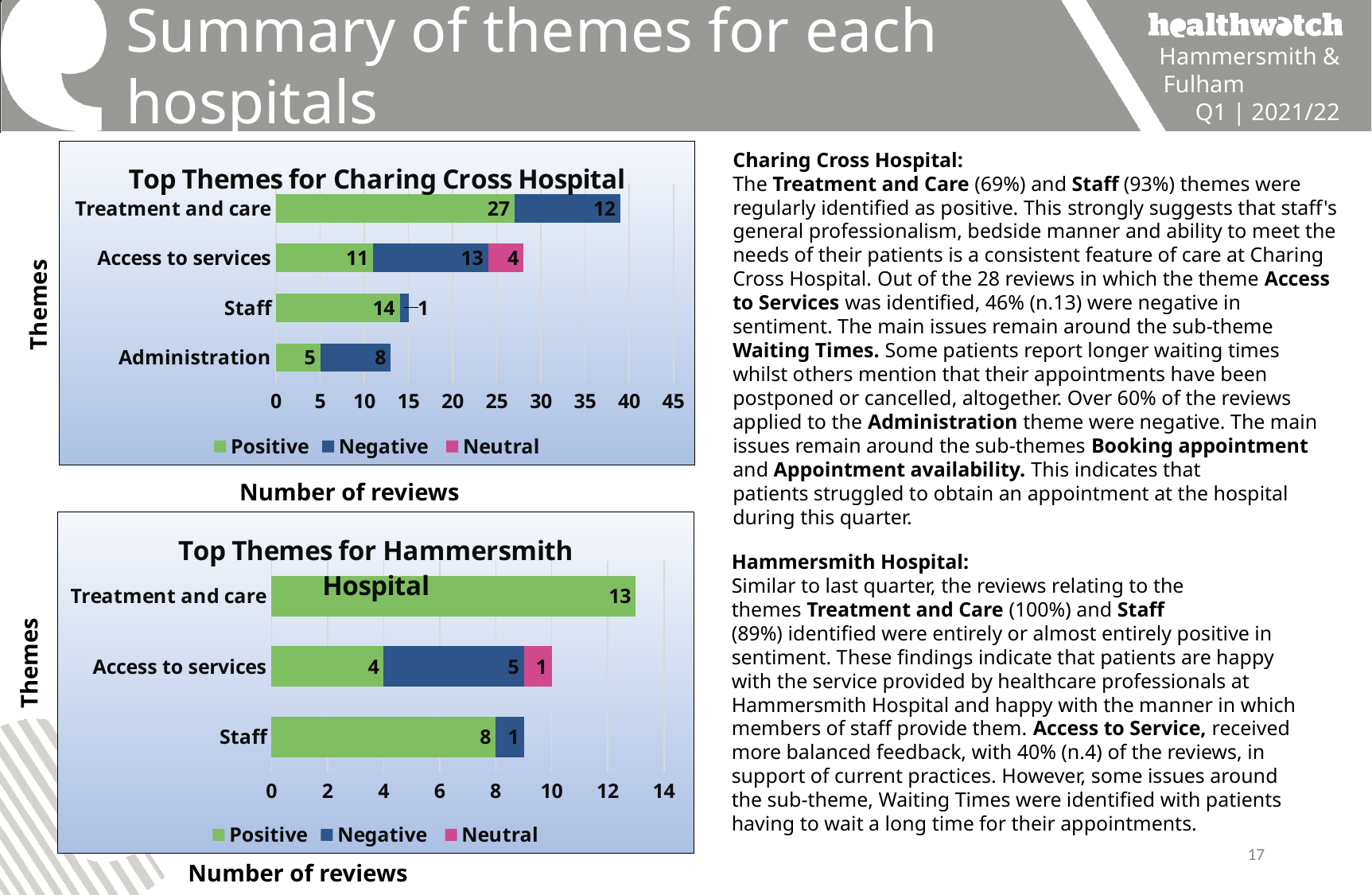
In the Top Themes for Charing Cross Hospital chart, which theme has the longest bar overall? Treatment and care In the Top Themes for Hammersmith Hospital chart, how many Positive reviews are shown for Treatment and care? 13 In the Top Themes for Charing Cross Hospital chart, what is the difference between the Negative and Positive reviews for Administration? 3 In the Top Themes for Hammersmith Hospital chart, what is the total number of reviews for Staff? 9 In the Top Themes for Charing Cross Hospital chart, what is the total number of reviews for Access to services across all three sentiments? 28 What type of chart is the Top Themes for Charing Cross Hospital chart? Stacked bar chart In the Top Themes for Charing Cross Hospital chart, how many themes are listed on the vertical axis? 4 In the Top Themes for Charing Cross Hospital chart, how many Negative reviews are shown for Access to services? 13 In the Top Themes for Hammersmith Hospital chart, how many Neutral reviews are shown for Access to services? 1 In the Top Themes for Hammersmith Hospital chart, which is larger: the Positive reviews for Staff or the Positive reviews for Access to services? Positive reviews for Staff In the Top Themes for Charing Cross Hospital chart, how many Positive reviews are shown for Treatment and care? 27 How many series does the legend list in the Top Themes for Hammersmith Hospital chart? 3